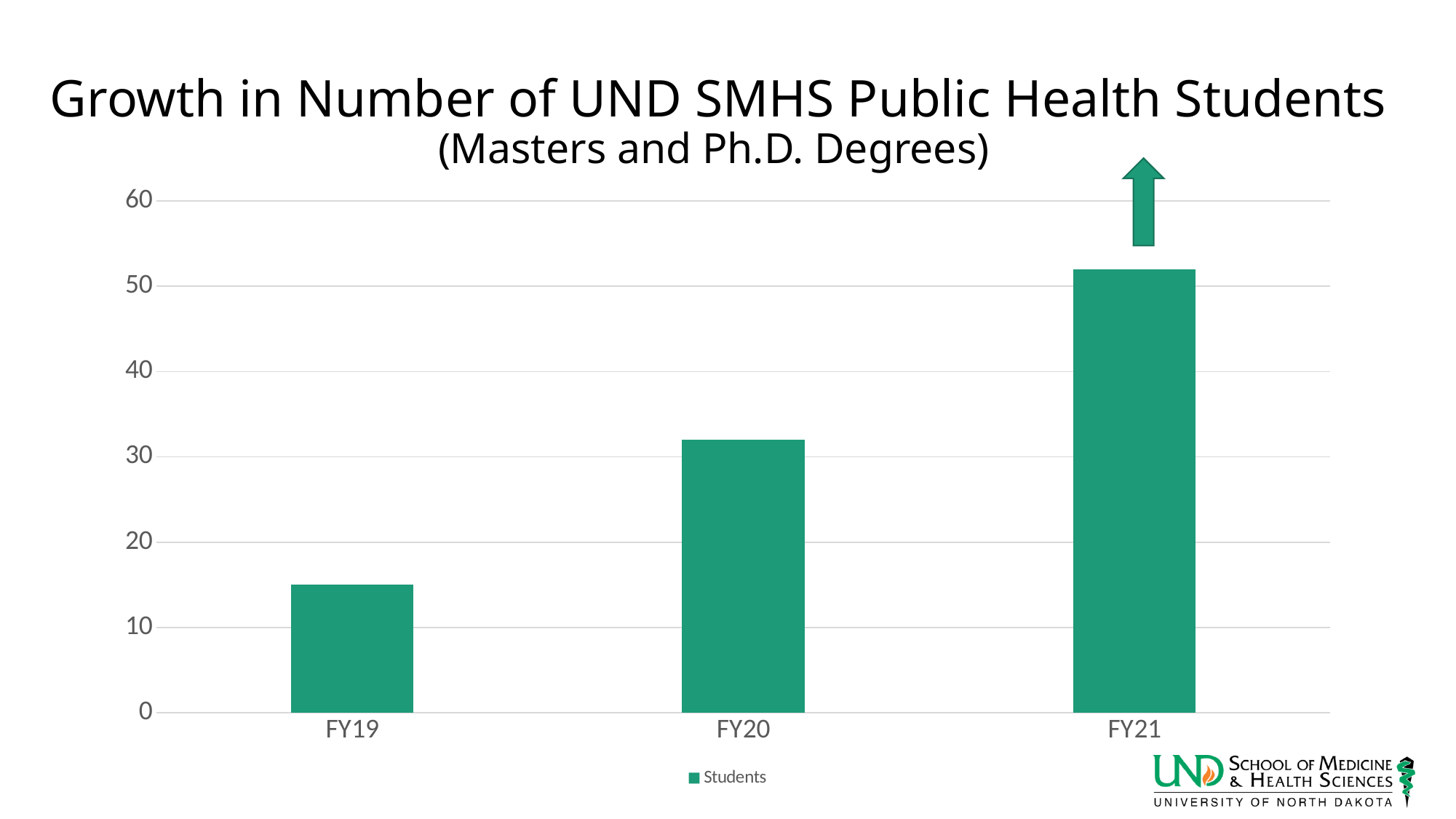
Which fiscal year has the lowest number of students? FY19 Which fiscal year has the highest number of students? FY21 Which is larger, the value for FY20 or the value for FY19? FY20 What is the subtitle shown under the chart title? (Masters and Ph.D. Degrees) How many series does the legend list? 1 What kind of chart is shown on the slide? bar chart Is the value for FY20 greater or less than 40? less Do the values rise or fall from FY19 to FY21? rise Is the value for FY21 greater or less than 40? greater Is the value for FY19 greater or less than 20? less What is the name of the series shown in the legend? Students How many fiscal years are plotted on the chart? 3